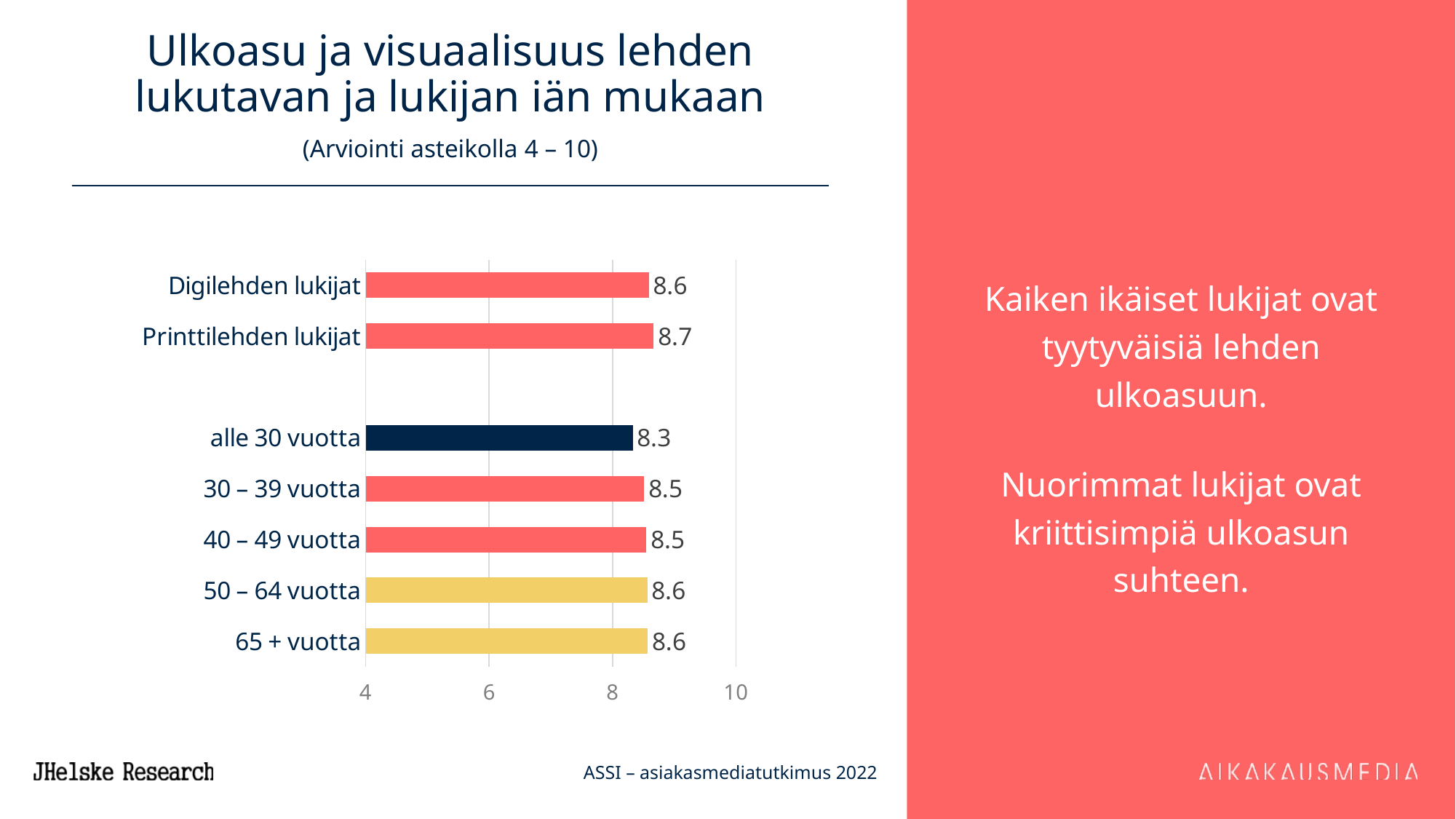
Which category has the lowest value? alle 30 vuotta What rating scale is stated under the chart title? 4 – 10 Which category has the highest value? Printtilehden lukijat Is the value for alle 30 vuotta greater or less than 8? greater What is the value for 50 – 64 vuotta? 8.6 How many categories are shown in the chart? 7 What is the value for alle 30 vuotta? 8.3 What kind of chart is shown on the slide? bar chart What is the difference between Printtilehden lukijat and alle 30 vuotta? 0.4 Which is larger, the value for Digilehden lukijat or the value for Printtilehden lukijat? Printtilehden lukijat What is the value for Digilehden lukijat? 8.6 What is the value for Printtilehden lukijat? 8.7